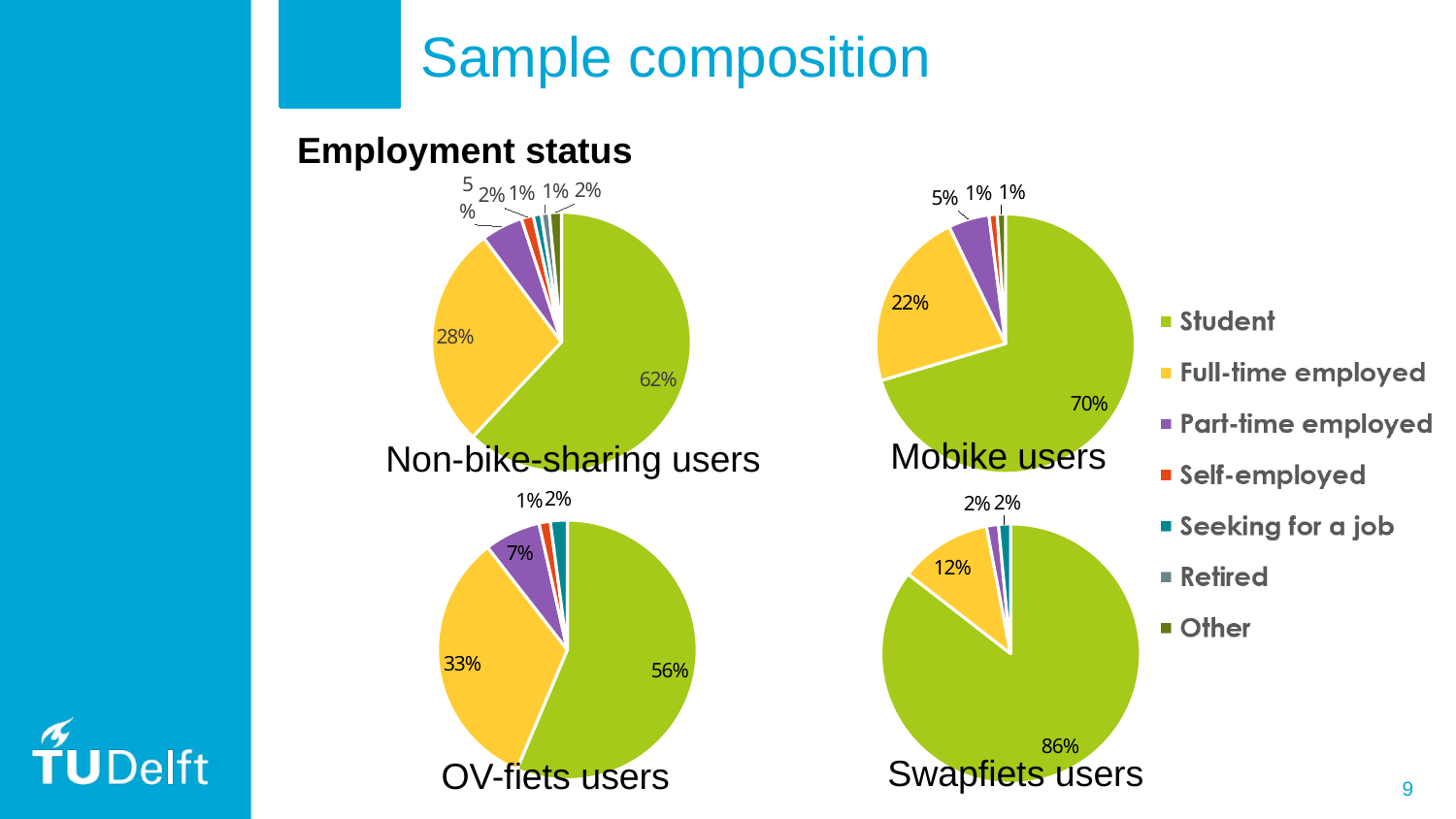
How many entries does the legend list? 7 In the Non-bike-sharing users pie chart, what is the difference between the Student share and the Full-time employed share? 34% In the Non-bike-sharing users pie chart, what share of the sample is Student? 62% In the OV-fiets users pie chart, which category has the largest share? Student In the Mobike users pie chart, what share of the sample is Full-time employed? 22% What kind of chart is used to show employment status on this slide? Pie chart Which is larger: the Full-time employed share for OV-fiets users or for Mobike users? OV-fiets users In the Swapfiets users pie chart, what is the difference between the Student share and the Full-time employed share? 74% In the Swapfiets users pie chart, what share of the sample is Student? 86% Which colour represents Student in the legend? Green In the OV-fiets users pie chart, what share of the sample is Part-time employed? 7% How many pie charts are shown on the slide? 4